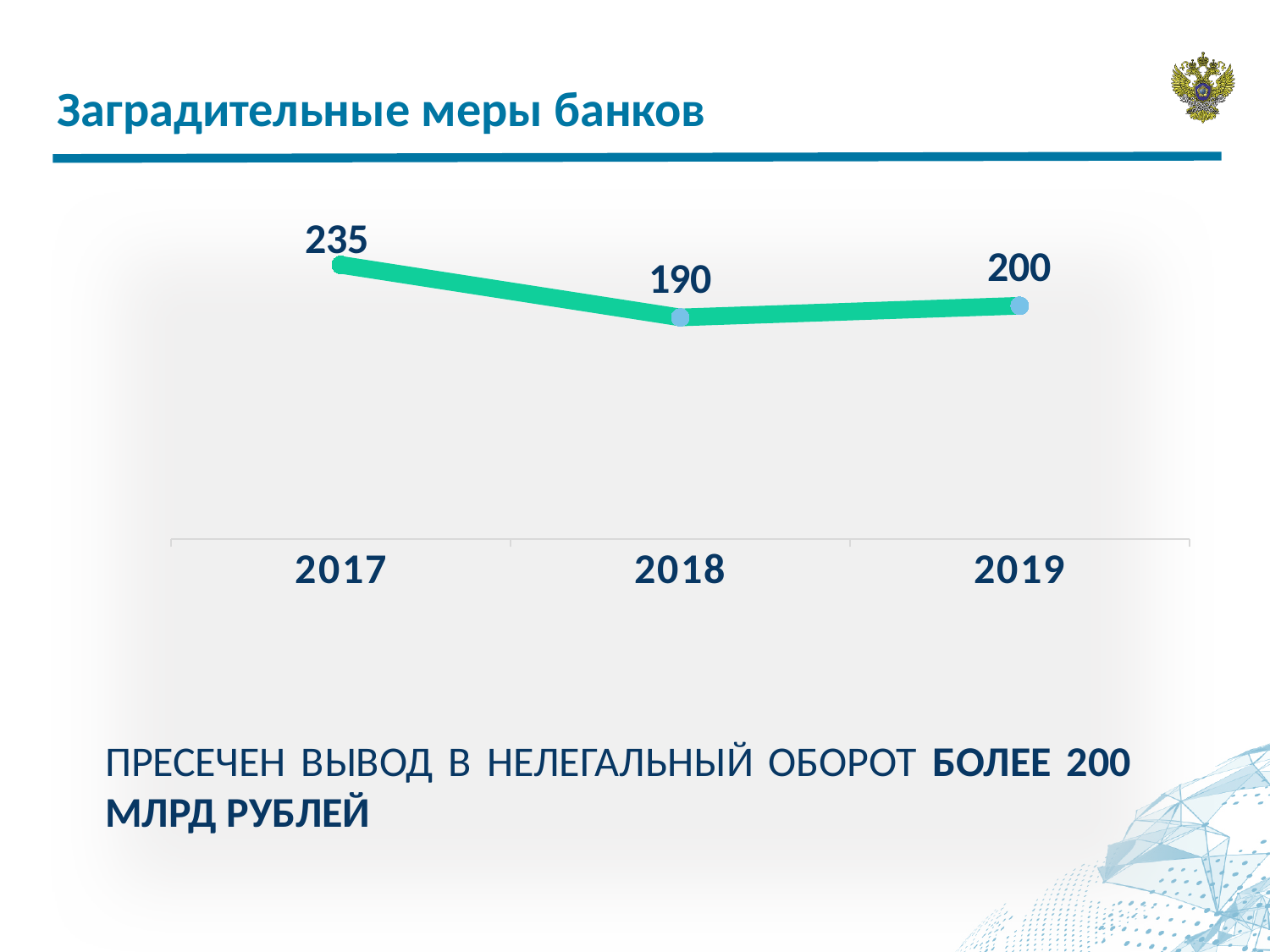
Does the value rise or fall from 2017 to 2018? fall Which year has the lowest value? 2018 What is the value for 2019? 200 What kind of chart is shown on the slide? line chart What is the value for 2017? 235 What is the value for 2018? 190 Which year has the highest value? 2017 Which is larger, the value for 2017 or the value for 2019? 2017 What is the difference between the values for 2019 and 2018? 10 What is the title of the slide? Заградительные меры банков How many years are plotted on the chart? 3 What is the difference between the values for 2017 and 2018? 45